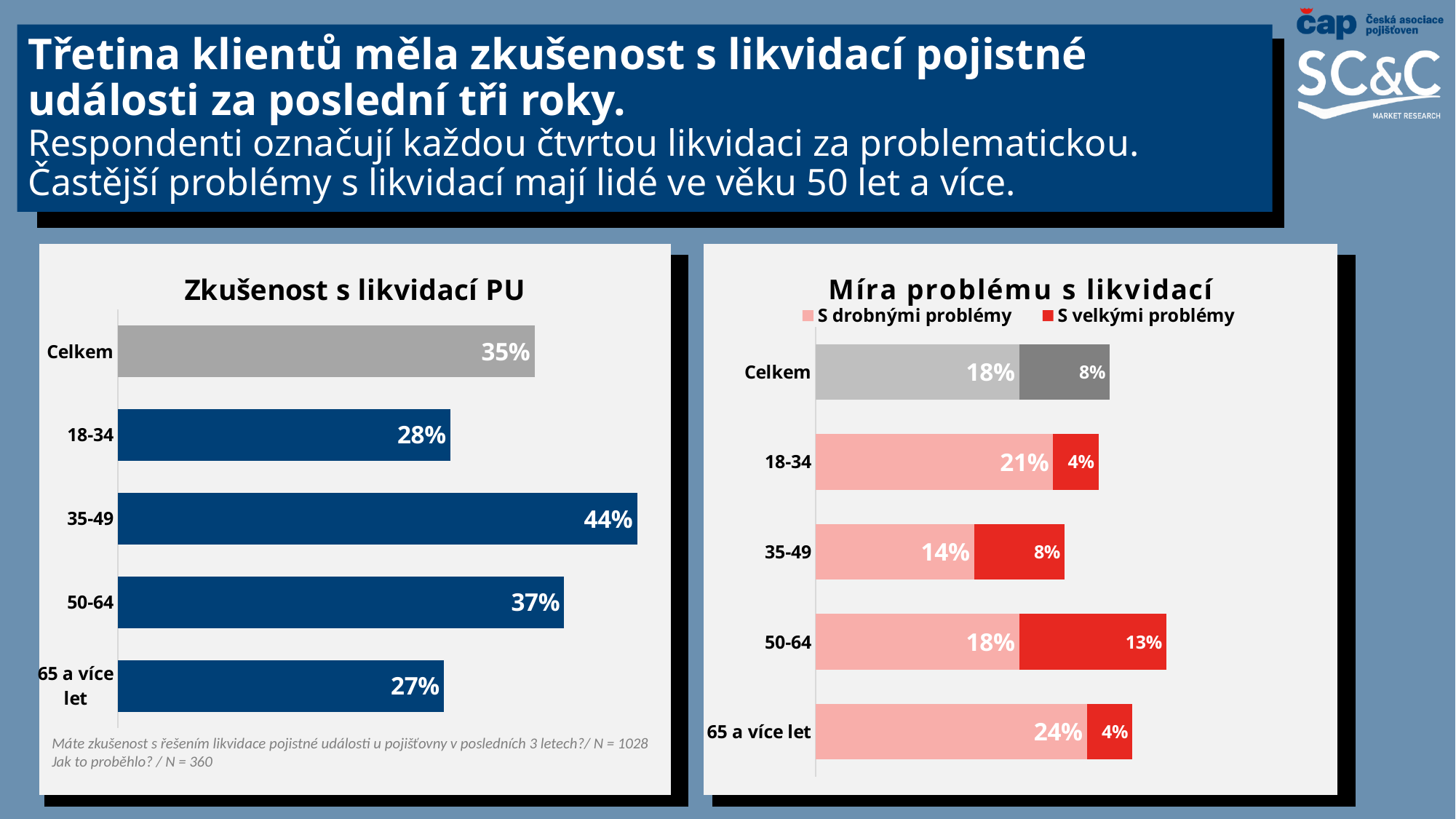
In the chart 'Zkušenost s likvidací PU', what is the value for 35-49? 44% In the chart 'Zkušenost s likvidací PU', which category has the lowest value? 65 a více let In the chart 'Zkušenost s likvidací PU', which category has the highest value? 35-49 In the chart 'Míra problému s likvidací', which category has the highest 'S velkými problémy' value? 50-64 In the chart 'Míra problému s likvidací', how many series does the legend list? 2 In the chart 'Zkušenost s likvidací PU', how many categories are shown? 5 In the chart 'Míra problému s likvidací', what is the value of 'S velkými problémy' for 50-64? 13% In the chart 'Zkušenost s likvidací PU', what is the difference between the values for 35-49 and 18-34? 16% In the chart 'Míra problému s likvidací', what is the total of the stacked bar for 50-64? 31% What kind of chart is 'Míra problému s likvidací'? Stacked bar chart In the chart 'Míra problému s likvidací', what is the value of 'S drobnými problémy' for 65 a více let? 24% In the chart 'Zkušenost s likvidací PU', what is the value for Celkem? 35%